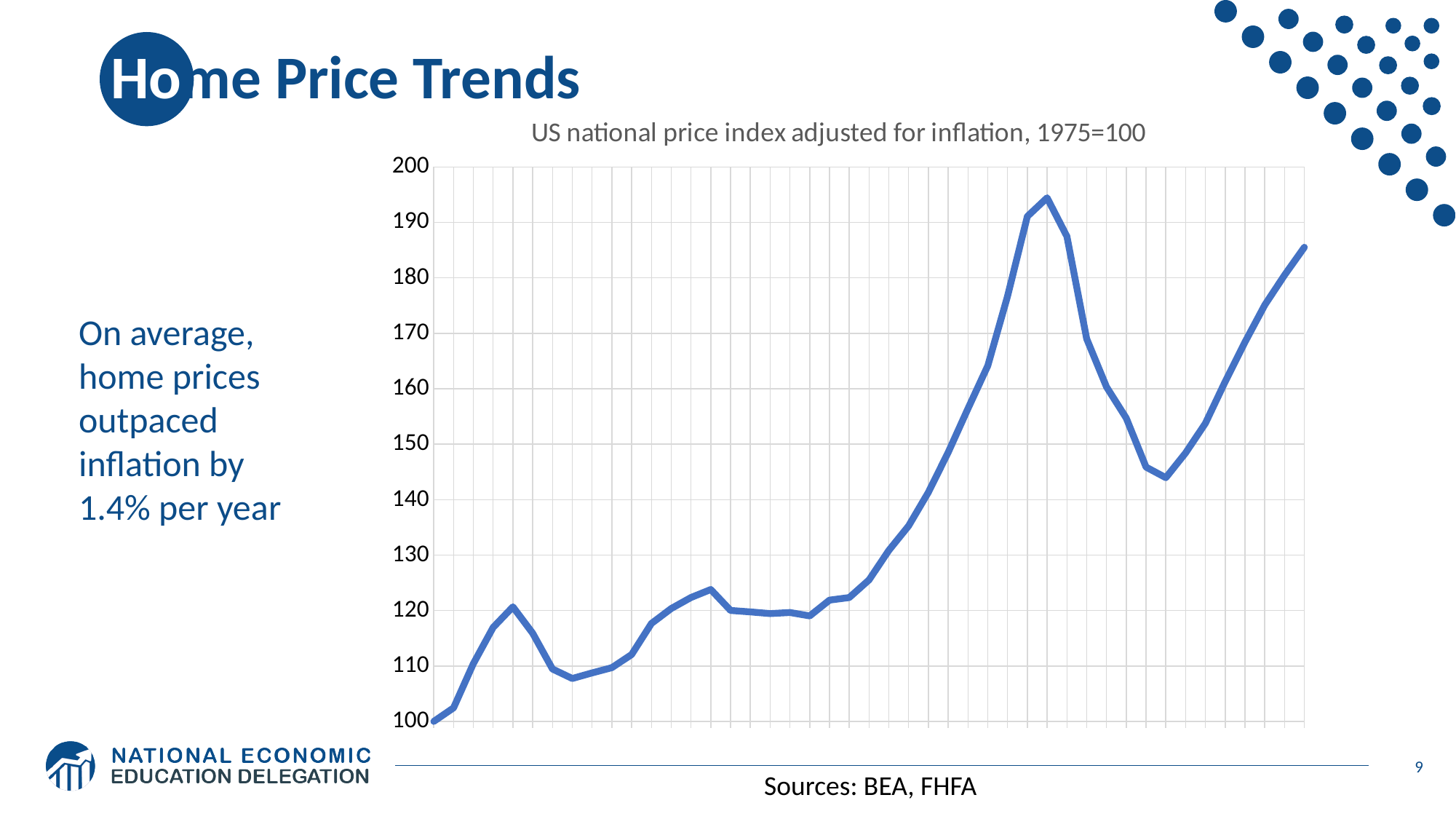
Overall, does the price index rise or fall from the left of the chart to the right? rise Is the value at the right-hand end of the line higher or lower than the value at the left-hand start? higher What is the highest value shown on the chart's vertical axis? 200 Is the value at the left-hand start of the line greater or less than 110? less Is the peak value of the price index greater or less than 190? greater Is the value at the first small peak near the left of the chart greater or less than 130? less What kind of chart is shown on the slide? line chart What is the title of the chart? US national price index adjusted for inflation, 1975=100 Is the value at the right-hand end of the line higher or lower than the value at the chart's highest peak? lower